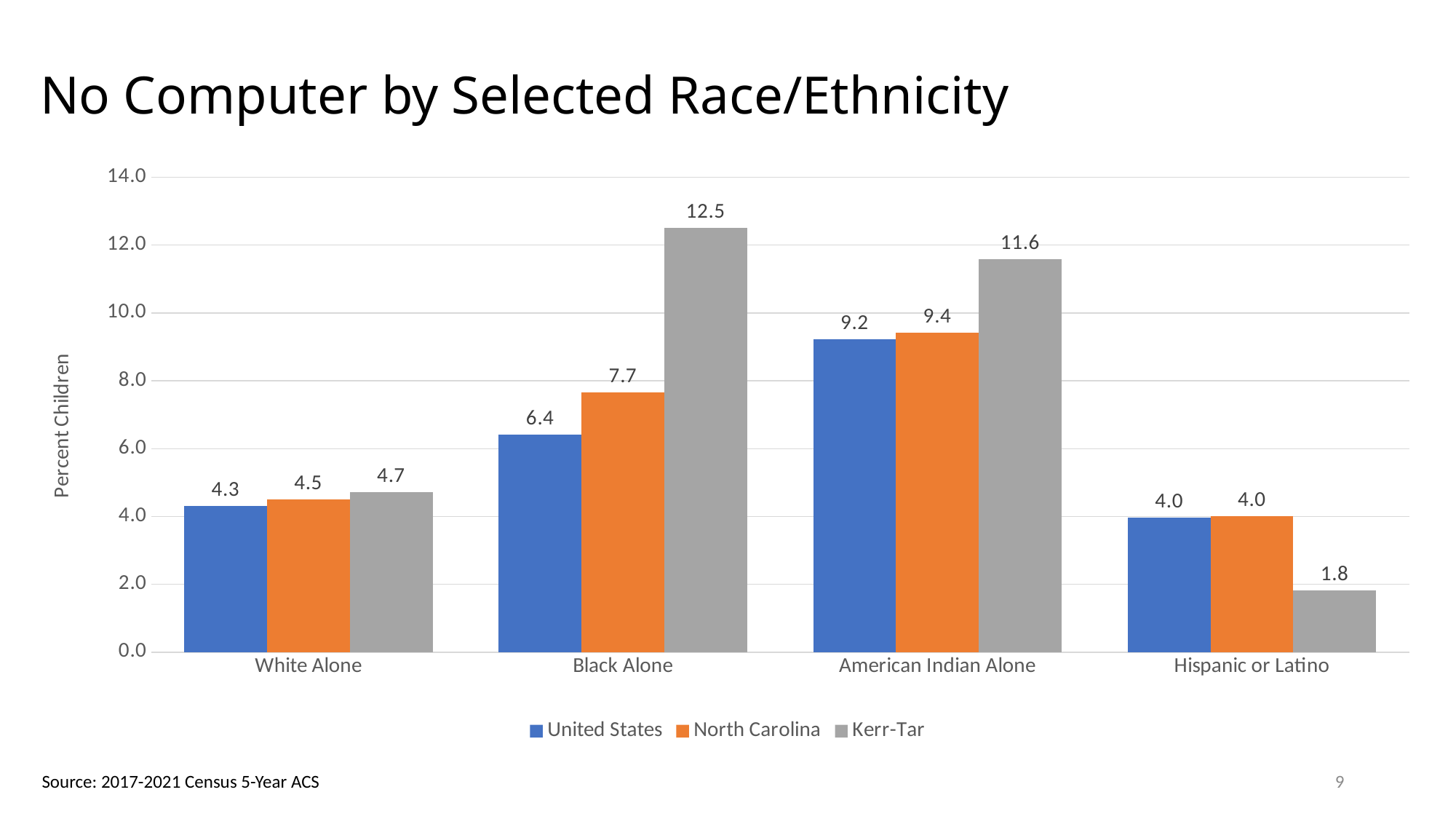
How many series does the legend list? 3 How many race/ethnicity categories are shown on the x axis? 4 What is the North Carolina value for White Alone? 4.5 What is the difference between the Kerr-Tar and United States values for Black Alone? 6.1 Which category has the lowest Kerr-Tar value? Hispanic or Latino What is the Kerr-Tar value for Black Alone? 12.5 Which category has the highest Kerr-Tar value? Black Alone Is the Kerr-Tar value for American Indian Alone greater or less than 10.0? greater What is the Kerr-Tar value for Hispanic or Latino? 1.8 What type of chart is shown on the slide? Bar chart What is the United States value for American Indian Alone? 9.2 For American Indian Alone, which is larger: the Kerr-Tar value or the North Carolina value? Kerr-Tar